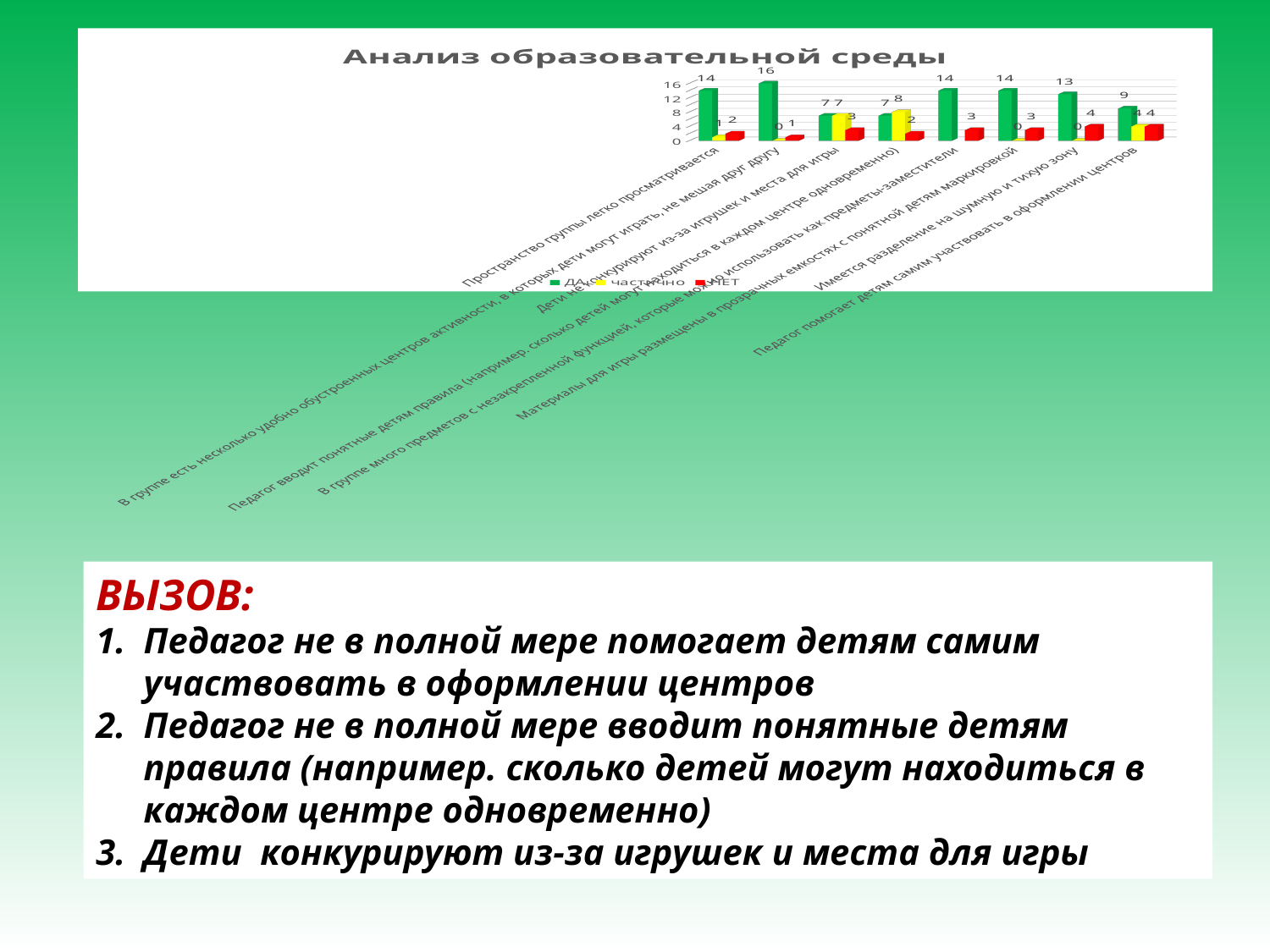
What is the НЕТ value for 'Имеется разделение на шумную и тихую зону'? 4 Which is larger: the ДА value for 'Имеется разделение на шумную и тихую зону' or the ДА value for 'Дети не конкурируют из-за игрушек и места для игры'? Имеется разделение на шумную и тихую зону Which category has the highest ДА value? В группе есть несколько удобно обустроенных центров активности, в которых дети могут играть, не мешая друг другу How many categories are plotted on the chart? 8 What are the series names in the legend of the chart? ДА, частично, НЕТ What kind of chart is shown on the slide? bar chart What is the title of the chart? Анализ образовательной среды What is the ДА value for 'Пространство группы легко просматривается'? 14 What is the ДА value for 'Педагог помогает детям самим участвовать в оформлении центров'? 9 What is the difference between the ДА value for 'Пространство группы легко просматривается' and the ДА value for 'Педагог помогает детям самим участвовать в оформлении центров'? 5 What is the ДА value for 'Имеется разделение на шумную и тихую зону'? 13 How many series does the legend of the chart list? 3